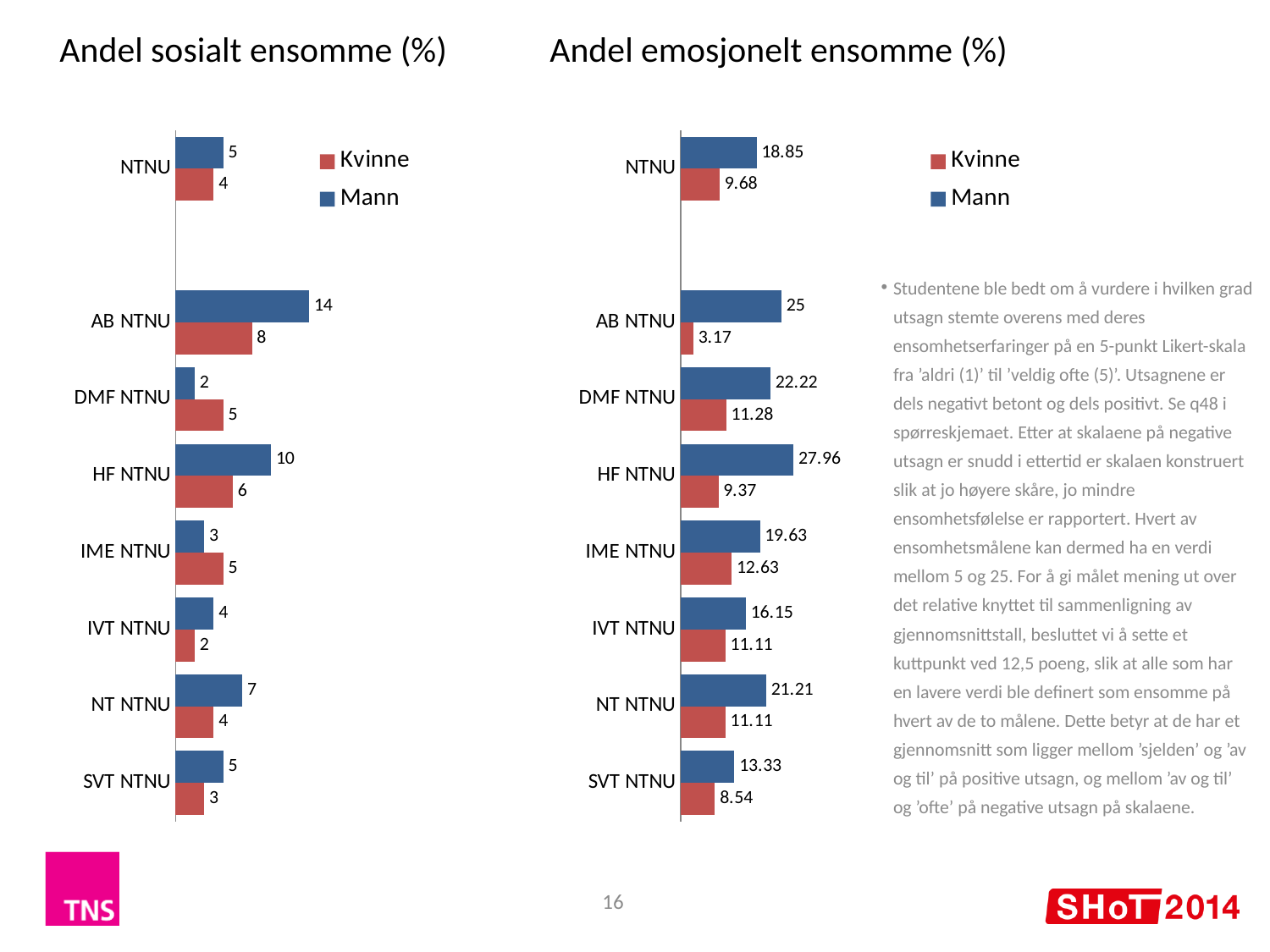
In the 'Andel sosialt ensomme (%)' chart, which category has the highest value for Mann? AB NTNU In the 'Andel sosialt ensomme (%)' chart, what is the difference between Mann and Kvinne at HF NTNU? 4 In the 'Andel emosjonelt ensomme (%)' chart, which category has the lowest value for Kvinne? AB NTNU In the 'Andel emosjonelt ensomme (%)' chart, what is the difference between Mann and Kvinne at IVT NTNU? 5.04 How many series does the legend of the 'Andel emosjonelt ensomme (%)' chart list? 2 In the 'Andel emosjonelt ensomme (%)' chart, what is the value for Mann at HF NTNU? 27.96 In the 'Andel sosialt ensomme (%)' chart, which is larger at IME NTNU, Kvinne or Mann? Kvinne In the 'Andel emosjonelt ensomme (%)' chart, which category has the lowest value for Mann? SVT NTNU In the 'Andel sosialt ensomme (%)' chart, what is the value for Kvinne at DMF NTNU? 5 In the 'Andel emosjonelt ensomme (%)' chart, what is the value for Kvinne at NTNU? 9.68 In the 'Andel sosialt ensomme (%)' chart, what is the value for Mann at AB NTNU? 14 What type of chart is 'Andel sosialt ensomme (%)'? Bar chart